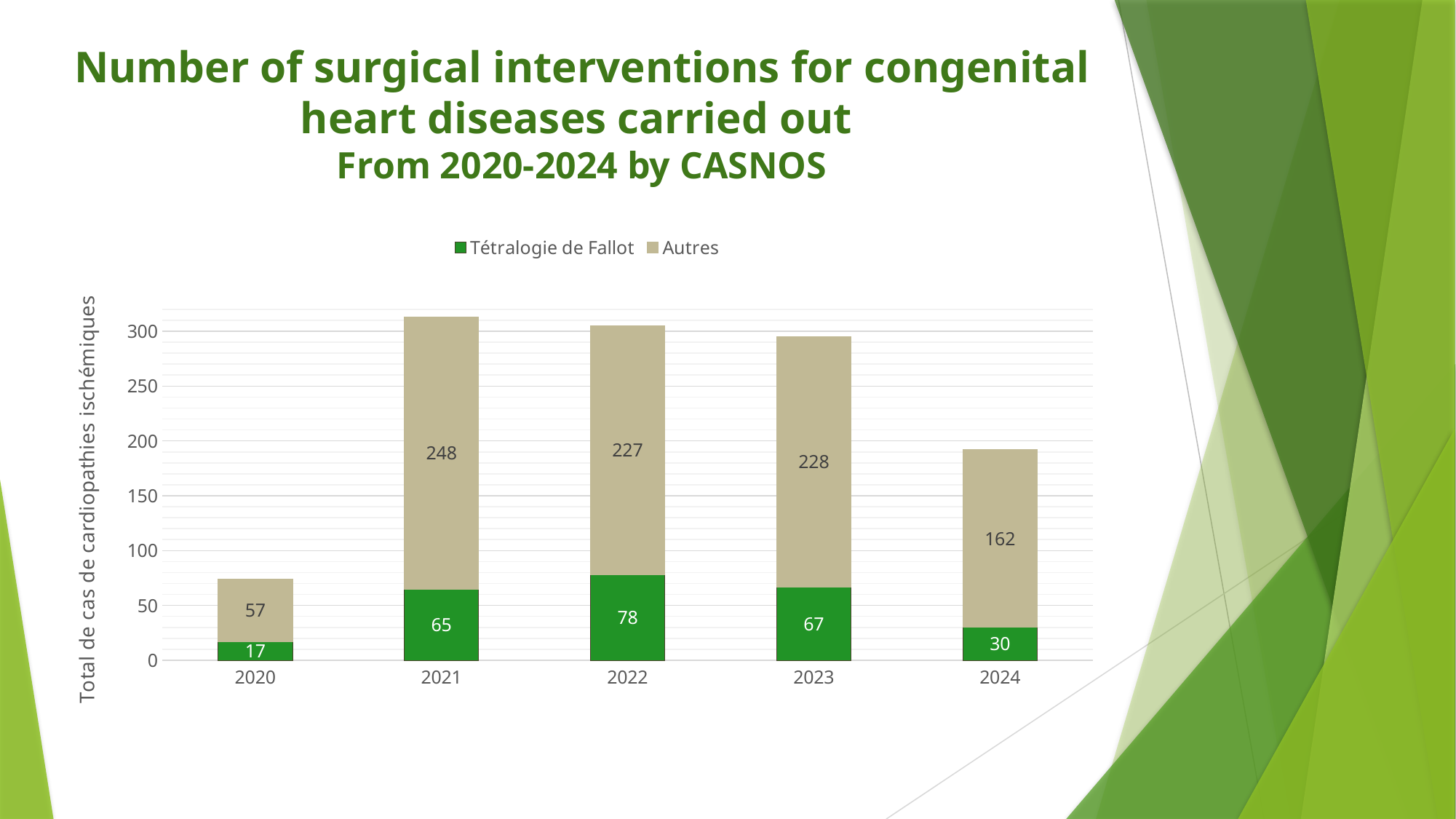
What kind of chart is shown on the slide? Stacked bar chart Which year has the highest value for Autres? 2021 Which year has the lowest value for Tétralogie de Fallot? 2020 What is the value for Tétralogie de Fallot in 2022? 78 What is the value for Autres in 2024? 162 What is the difference between the Autres values for 2021 and 2024? 86 What is the total of the stacked bar for 2021? 313 How many years are shown on the x axis? 5 What is the total of the stacked bar for 2020? 74 What is the value for Tétralogie de Fallot in 2020? 17 Which is larger, the Tétralogie de Fallot value for 2021 or for 2023? 2023 How many series does the legend list? 2